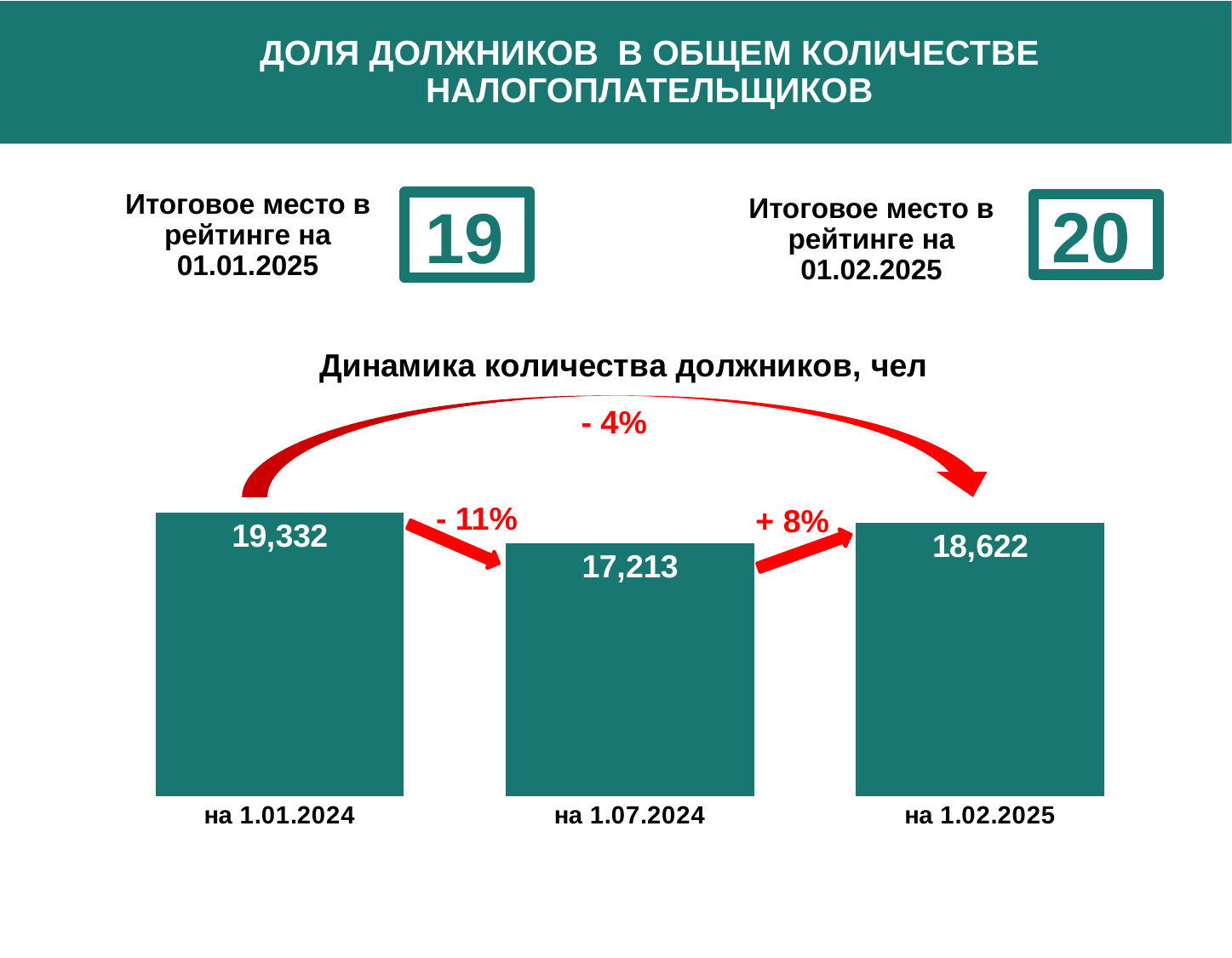
What is the number of debtors shown for на 1.01.2024? 19,332 What kind of chart is shown on the slide? bar chart Which is larger: the number of debtors on 1.01.2024 or on 1.02.2025? на 1.01.2024 What percentage change is shown between 1.07.2024 and 1.02.2025? + 8% What is the difference between the number of debtors on 1.02.2025 and on 1.07.2024? 1,409 What is the number of debtors shown for на 1.07.2024? 17,213 What is the number of debtors shown for на 1.02.2025? 18,622 Which date has the lowest number of debtors? на 1.07.2024 What is the difference between the number of debtors on 1.01.2024 and on 1.07.2024? 2,119 Which date has the highest number of debtors? на 1.01.2024 How many bars are shown in the chart? 3 What is the title of the chart? Динамика количества должников, чел